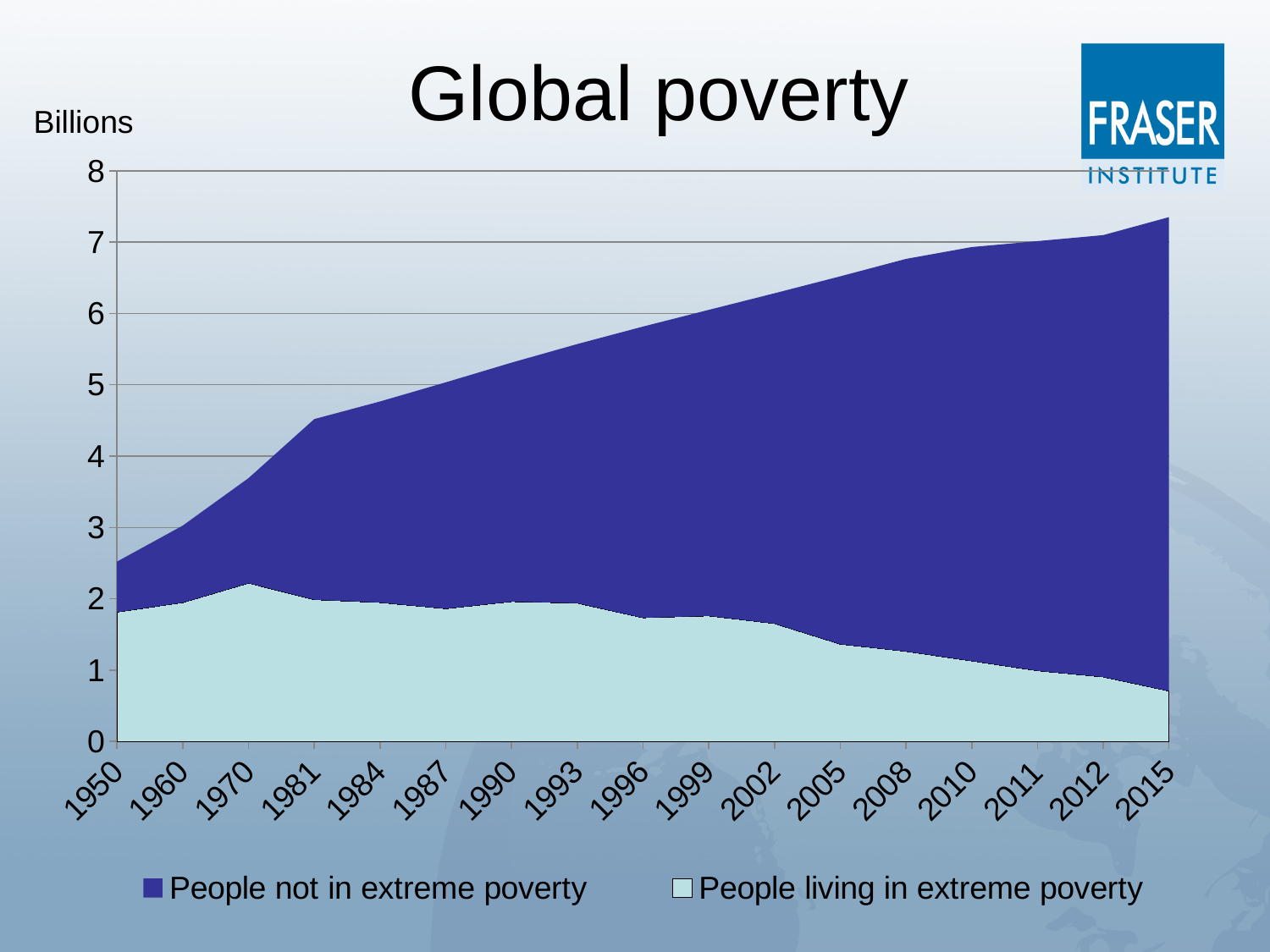
Which series is shown in dark blue? People not in extreme poverty What kind of chart is shown on the slide? Stacked area chart In which year is the number of people living in extreme poverty lowest? 2015 Is the value for people living in extreme poverty in 2015 greater or less than 1 billion? less How many years are labelled along the x axis? 17 In which year is the number of people living in extreme poverty highest? 1970 Is the total of the stacked areas in 2015 greater or less than 7 billion? greater Does the number of people living in extreme poverty rise or fall from 1970 to 2015? Fall What unit is given for the y axis? Billions Does the total population (top of the stacked area) rise or fall from 1950 to 2015? Rise Is the total of the stacked areas in 1950 greater or less than 3 billion? less How many series does the legend list? 2